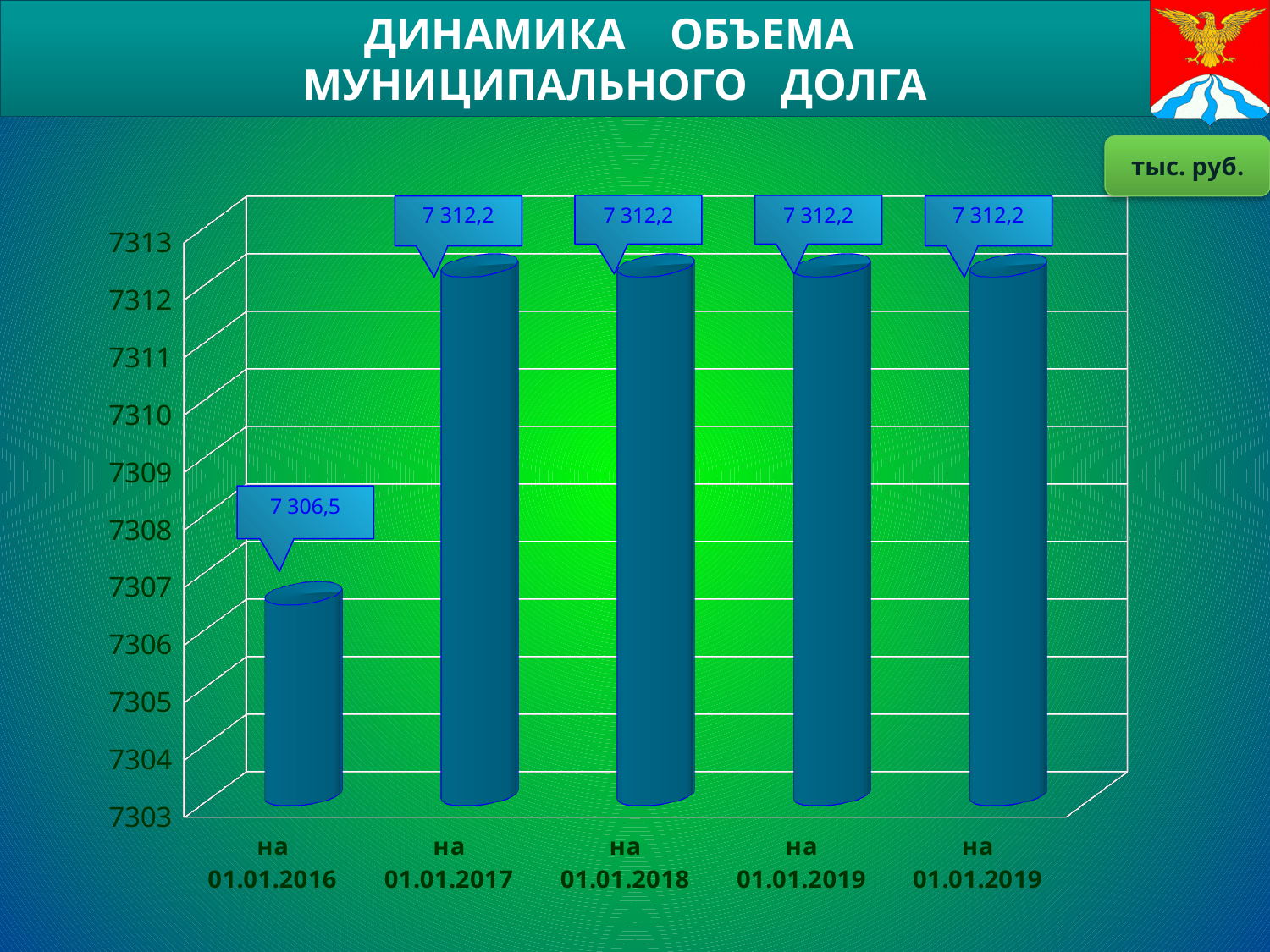
Does the value rise or fall from на 01.01.2016 to на 01.01.2017? rise Is the value for на 01.01.2016 greater or less than 7310? less What is the value for на 01.01.2017? 7 312,2 Which is larger, the value for на 01.01.2016 or the value for на 01.01.2018? на 01.01.2018 How many bars are shown in the chart? 5 What is the difference between the values for на 01.01.2017 and на 01.01.2016? 5,7 Is the value for на 01.01.2017 greater or less than 7310? greater Which category has the lowest value? на 01.01.2016 In what units are the values on the chart given? тыс. руб. What kind of chart is shown on the slide? bar chart What is the value for на 01.01.2016? 7 306,5 What is the value for на 01.01.2018? 7 312,2